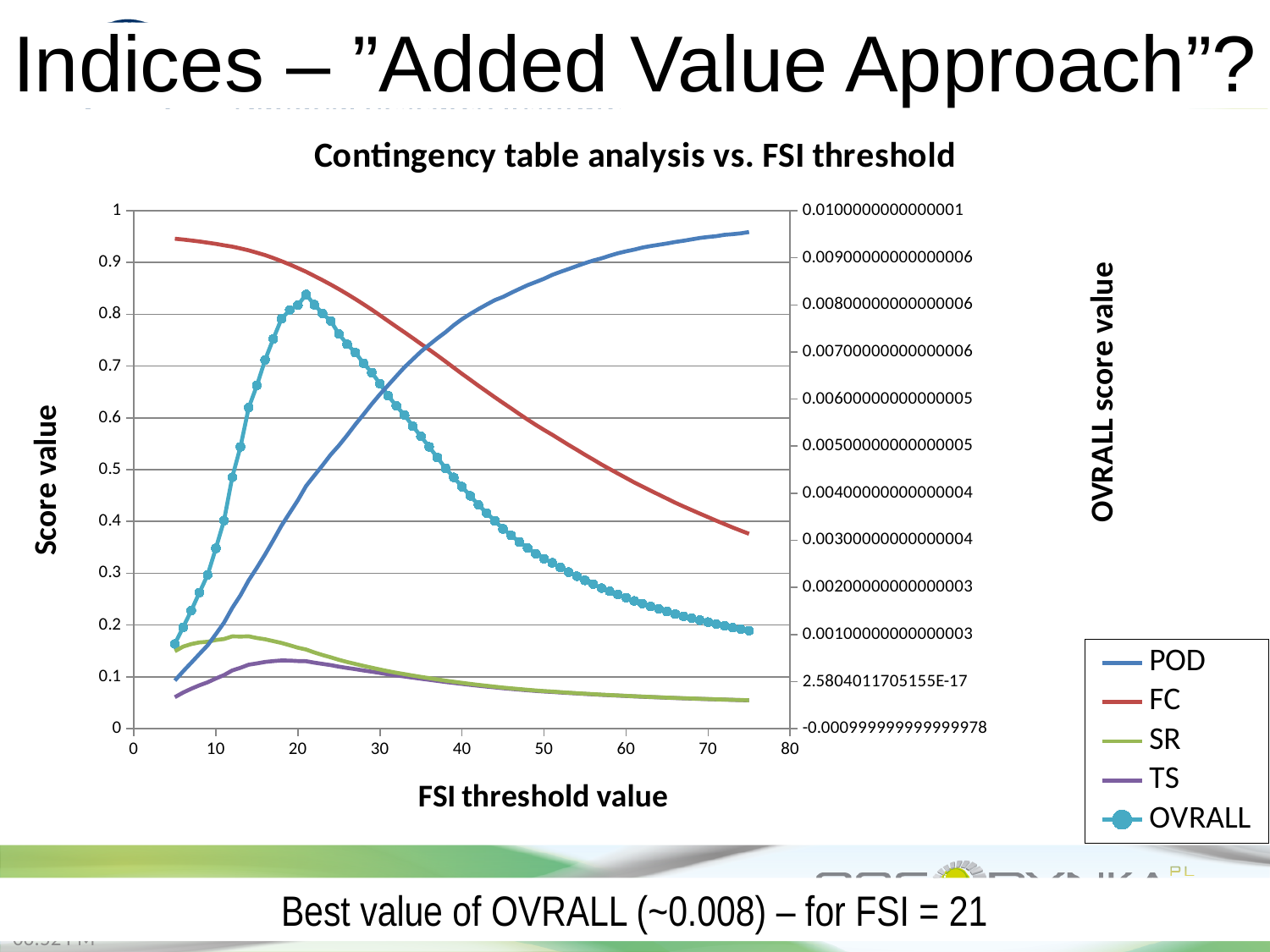
Is the value of TS at an FSI threshold of 20 greater or less than 0.2? less Is the value of POD at an FSI threshold of 70 greater or less than 0.9? greater What kind of chart is shown on the slide? line chart Is the value of FC at an FSI threshold of 75 greater or less than 0.4? less At an FSI threshold of 10, which series has the higher score value, POD or FC? FC Does the POD series rise or fall as the FSI threshold value increases? rises Does the FC series rise or fall as the FSI threshold value increases? falls Which series is drawn with circular markers? OVRALL How many series does the legend list? 5 At an FSI threshold of 60, which series has the higher score value, POD or FC? POD What is the title of the chart? Contingency table analysis vs. FSI threshold